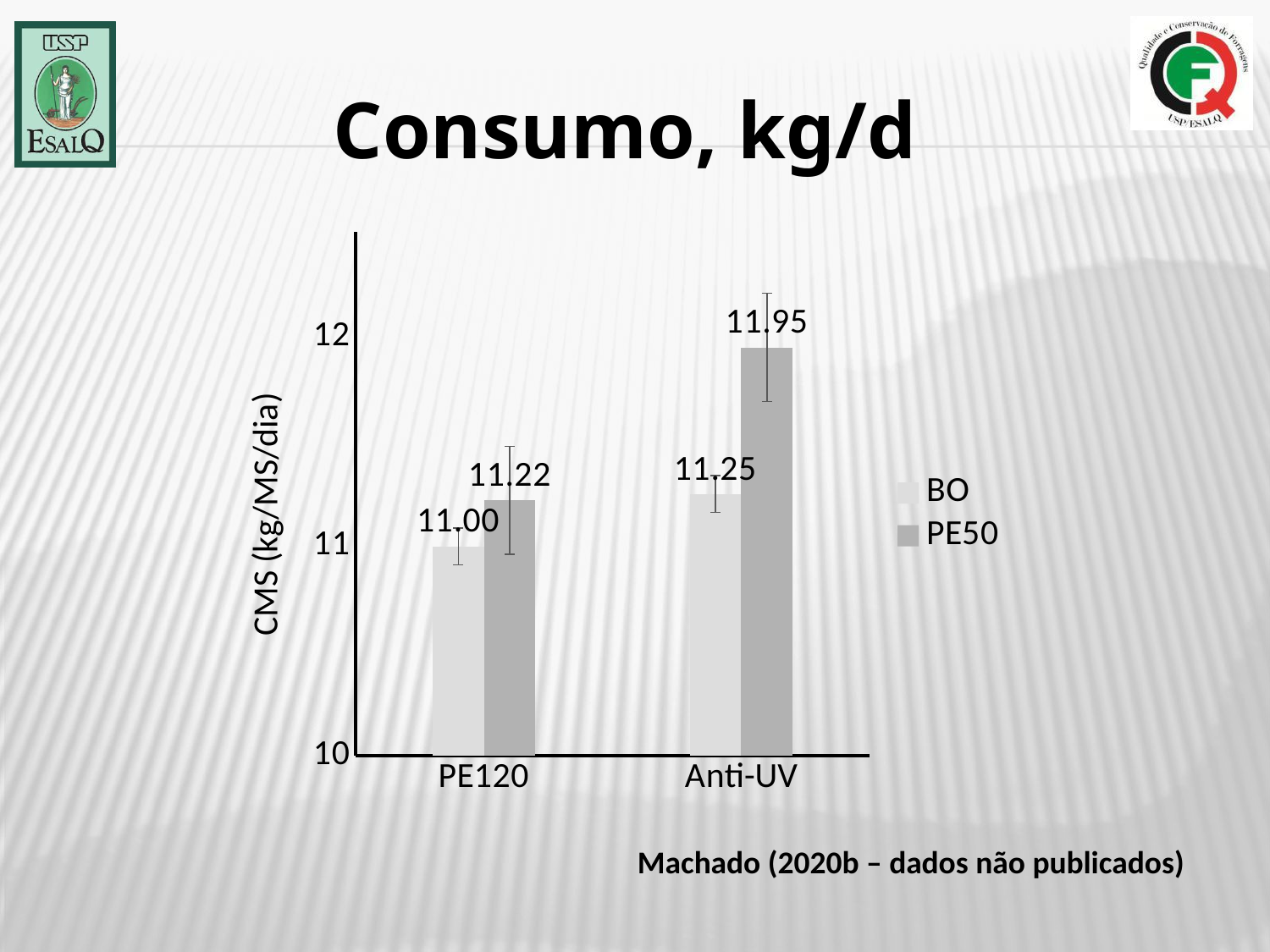
Which is larger, the BO value for Anti-UV or the PE50 value for PE120? BO value for Anti-UV What is the value for BO in the Anti-UV category? 11.25 Which bar has the highest value on the chart? PE50 in Anti-UV Which bar has the lowest value on the chart? BO in PE120 What is the value for PE50 in the PE120 category? 11.22 What is the value for BO in the PE120 category? 11.00 How many series does the legend list? 2 What is the value for PE50 in the Anti-UV category? 11.95 What is the difference between the PE50 values for Anti-UV and PE120? 0.73 What is the y-axis label of the chart? CMS (kg/MS/dia) How many categories are shown on the x axis? 2 What is the difference between the PE50 and BO values in the Anti-UV category? 0.70